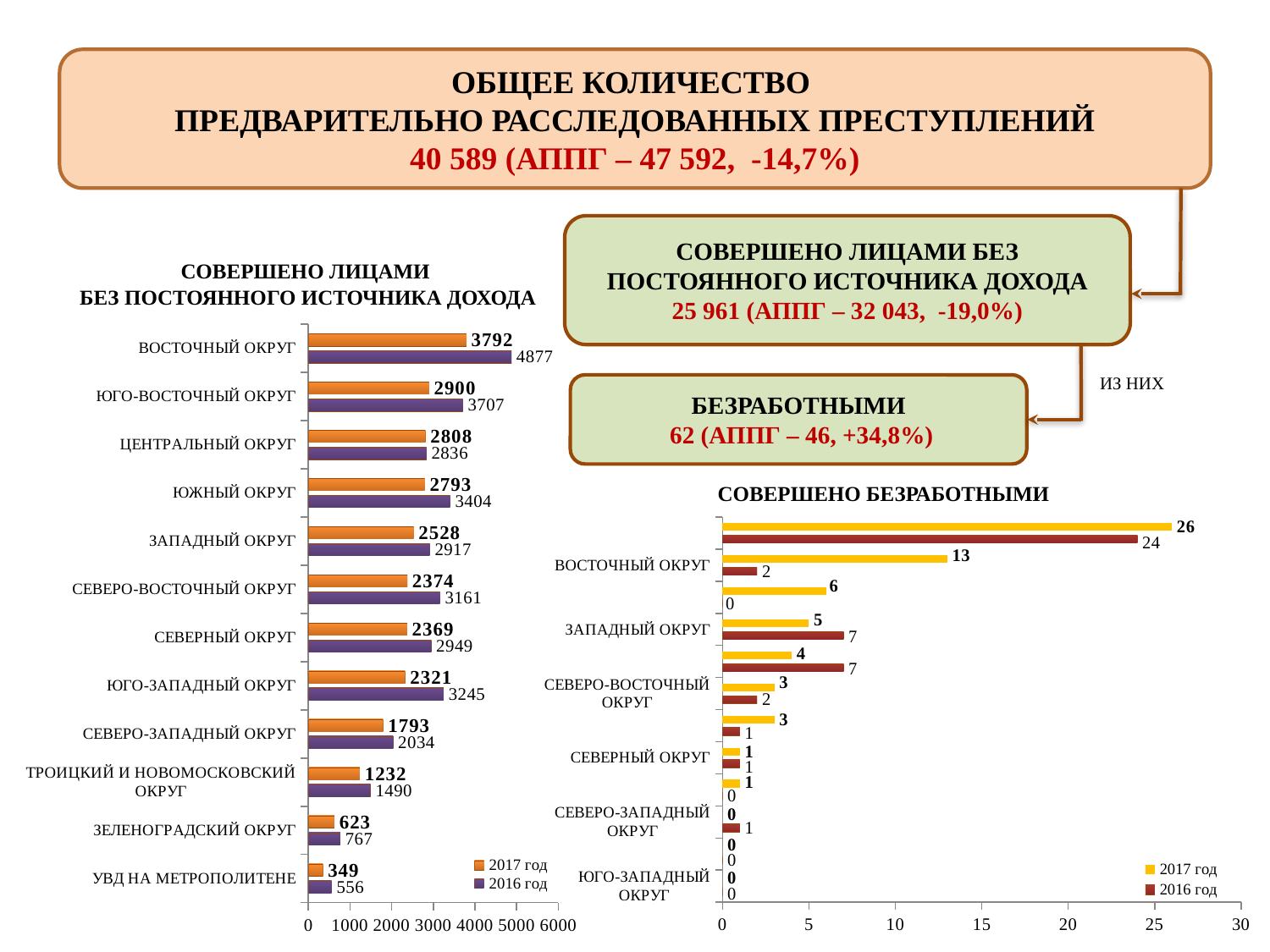
What kind of chart is the chart titled «СОВЕРШЕНО БЕЗРАБОТНЫМИ»? Bar chart In the chart titled «СОВЕРШЕНО ЛИЦАМИ БЕЗ ПОСТОЯННОГО ИСТОЧНИКА ДОХОДА», which category has the highest 2017 год value? ВОСТОЧНЫЙ ОКРУГ In the chart titled «СОВЕРШЕНО ЛИЦАМИ БЕЗ ПОСТОЯННОГО ИСТОЧНИКА ДОХОДА», what is the 2017 год value for ВОСТОЧНЫЙ ОКРУГ? 3792 In the chart titled «СОВЕРШЕНО ЛИЦАМИ БЕЗ ПОСТОЯННОГО ИСТОЧНИКА ДОХОДА», which has the larger 2016 год value: ЮЖНЫЙ ОКРУГ or ЦЕНТРАЛЬНЫЙ ОКРУГ? ЮЖНЫЙ ОКРУГ In the chart titled «СОВЕРШЕНО ЛИЦАМИ БЕЗ ПОСТОЯННОГО ИСТОЧНИКА ДОХОДА», what is the 2017 год value for ТРОИЦКИЙ И НОВОМОСКОВСКИЙ ОКРУГ? 1232 In the chart titled «СОВЕРШЕНО БЕЗРАБОТНЫМИ», what is the largest value shown on any bar? 26 In the chart titled «СОВЕРШЕНО ЛИЦАМИ БЕЗ ПОСТОЯННОГО ИСТОЧНИКА ДОХОДА», what is the difference between the 2016 год and 2017 год values for ВОСТОЧНЫЙ ОКРУГ? 1085 In the chart titled «СОВЕРШЕНО ЛИЦАМИ БЕЗ ПОСТОЯННОГО ИСТОЧНИКА ДОХОДА», how many series does the legend list? 2 In the chart titled «СОВЕРШЕНО БЕЗРАБОТНЫМИ», which series is shown in yellow according to the legend? 2017 год In the chart titled «СОВЕРШЕНО ЛИЦАМИ БЕЗ ПОСТОЯННОГО ИСТОЧНИКА ДОХОДА», how many categories are shown? 12 In the chart titled «СОВЕРШЕНО ЛИЦАМИ БЕЗ ПОСТОЯННОГО ИСТОЧНИКА ДОХОДА», what is the 2016 год value for ЗЕЛЕНОГРАДСКИЙ ОКРУГ? 767 In the chart titled «СОВЕРШЕНО ЛИЦАМИ БЕЗ ПОСТОЯННОГО ИСТОЧНИКА ДОХОДА», which category has the lowest 2016 год value? УВД НА МЕТРОПОЛИТЕНЕ